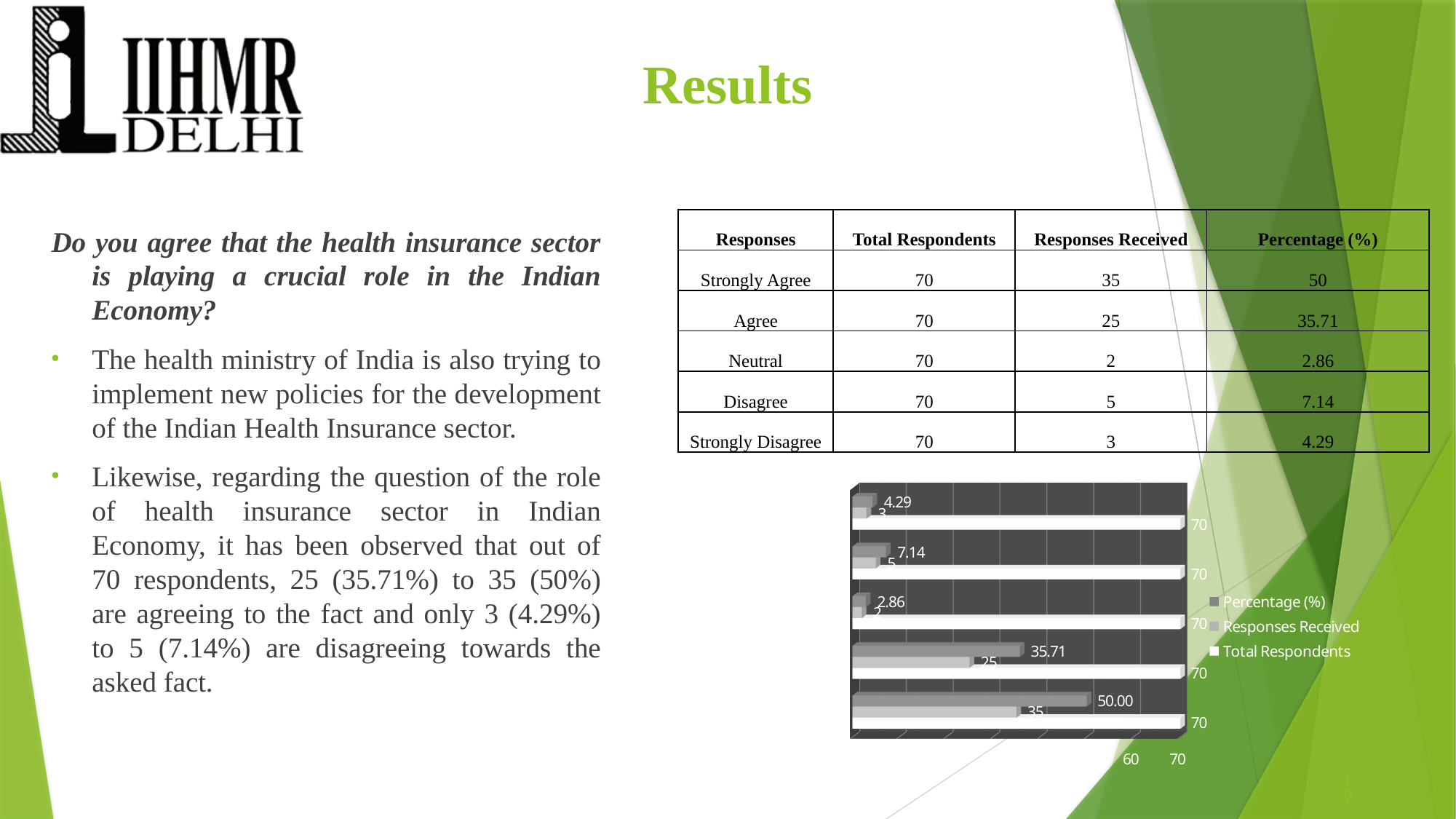
What is the difference between the two largest Percentage (%) values labelled in the chart, 50.00 and 35.71? 14.29 What is the lowest Percentage (%) value labelled in the chart? 2.86 What value is labelled for Total Respondents in each group of bars? 70 Is the Responses Received value in the bottom group of bars greater or less than 60? less What are the three series named in the chart's legend? Percentage (%), Responses Received, Total Respondents How many series does the chart's legend list? 3 How many groups of bars are plotted in the chart? 5 What is the highest Percentage (%) value labelled in the chart? 50.00 What kind of chart is shown on the slide? Bar chart Which is larger: the Responses Received value in the bottom group of bars or in the second group from the bottom? The bottom group What is the Responses Received value labelled in the bottom group of bars? 35 What is the Percentage (%) value labelled in the second group of bars from the bottom? 35.71